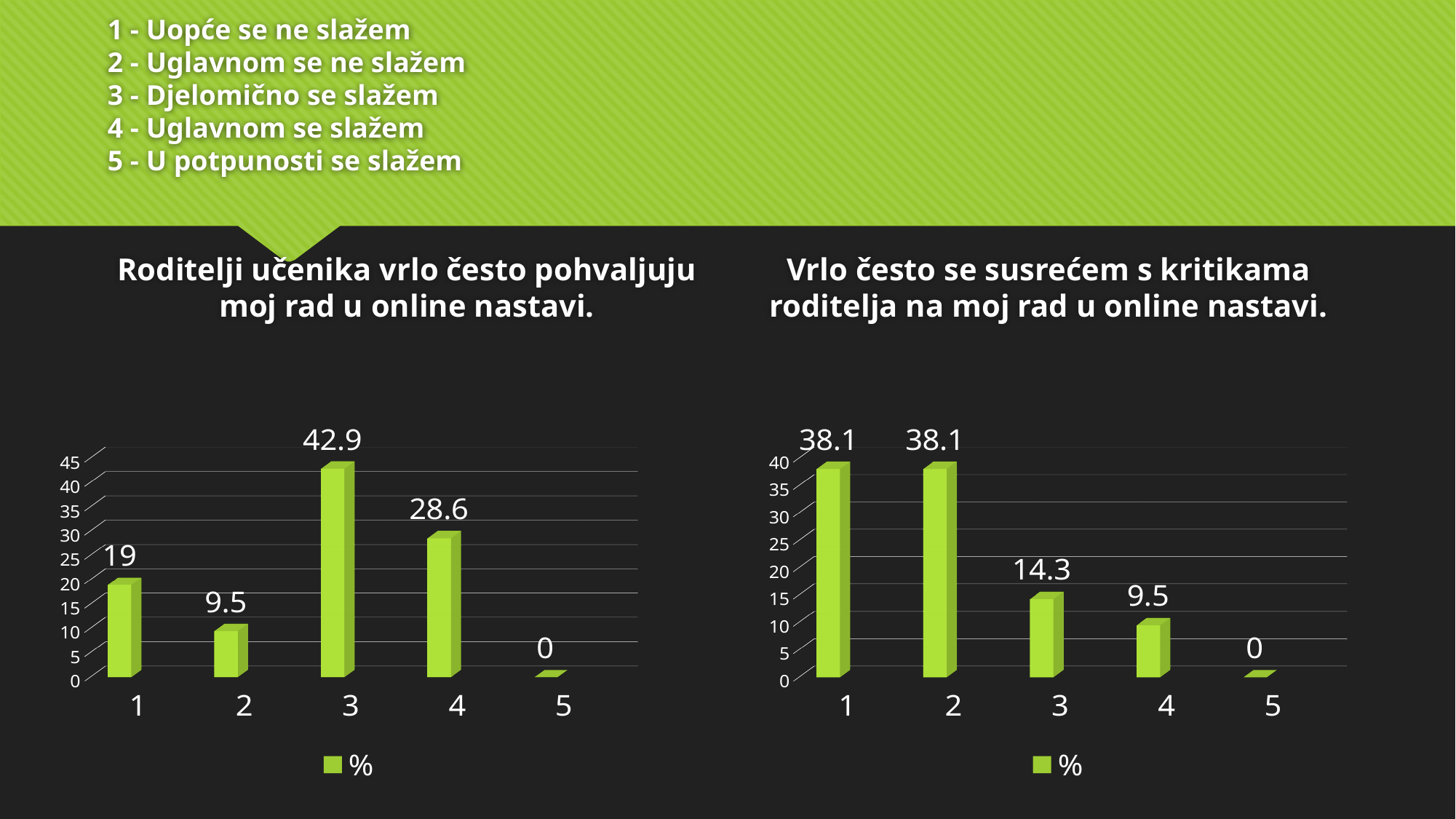
In the left chart (Roditelji učenika vrlo često pohvaljuju moj rad u online nastavi), which category has the lowest value? 5 In the right chart (Vrlo često se susrećem s kritikama roditelja na moj rad u online nastavi), what is the value for category 4? 9.5 In the left chart (Roditelji učenika vrlo često pohvaljuju moj rad u online nastavi), which category has the highest value? 3 In the left chart (Roditelji učenika vrlo često pohvaljuju moj rad u online nastavi), what is the difference between the values for category 3 and category 4? 14.3 In the right chart (Vrlo često se susrećem s kritikama roditelja na moj rad u online nastavi), what is the value for category 3? 14.3 In the right chart (Vrlo često se susrećem s kritikama roditelja na moj rad u online nastavi), which category has the lowest value? 5 How many series does the legend of the left chart (Roditelji učenika vrlo često pohvaljuju moj rad u online nastavi) list? 1 In the left chart (Roditelji učenika vrlo često pohvaljuju moj rad u online nastavi), which is larger, the value for category 1 or category 2? Category 1 How many categories are shown on the x axis of the right chart (Vrlo često se susrećem s kritikama roditelja na moj rad u online nastavi)? 5 In the left chart (Roditelji učenika vrlo često pohvaljuju moj rad u online nastavi), what is the value for category 3? 42.9 In the right chart (Vrlo često se susrećem s kritikama roditelja na moj rad u online nastavi), what is the difference between the values for category 1 and category 3? 23.8 What type of chart is the left chart (Roditelji učenika vrlo često pohvaljuju moj rad u online nastavi)? Bar chart